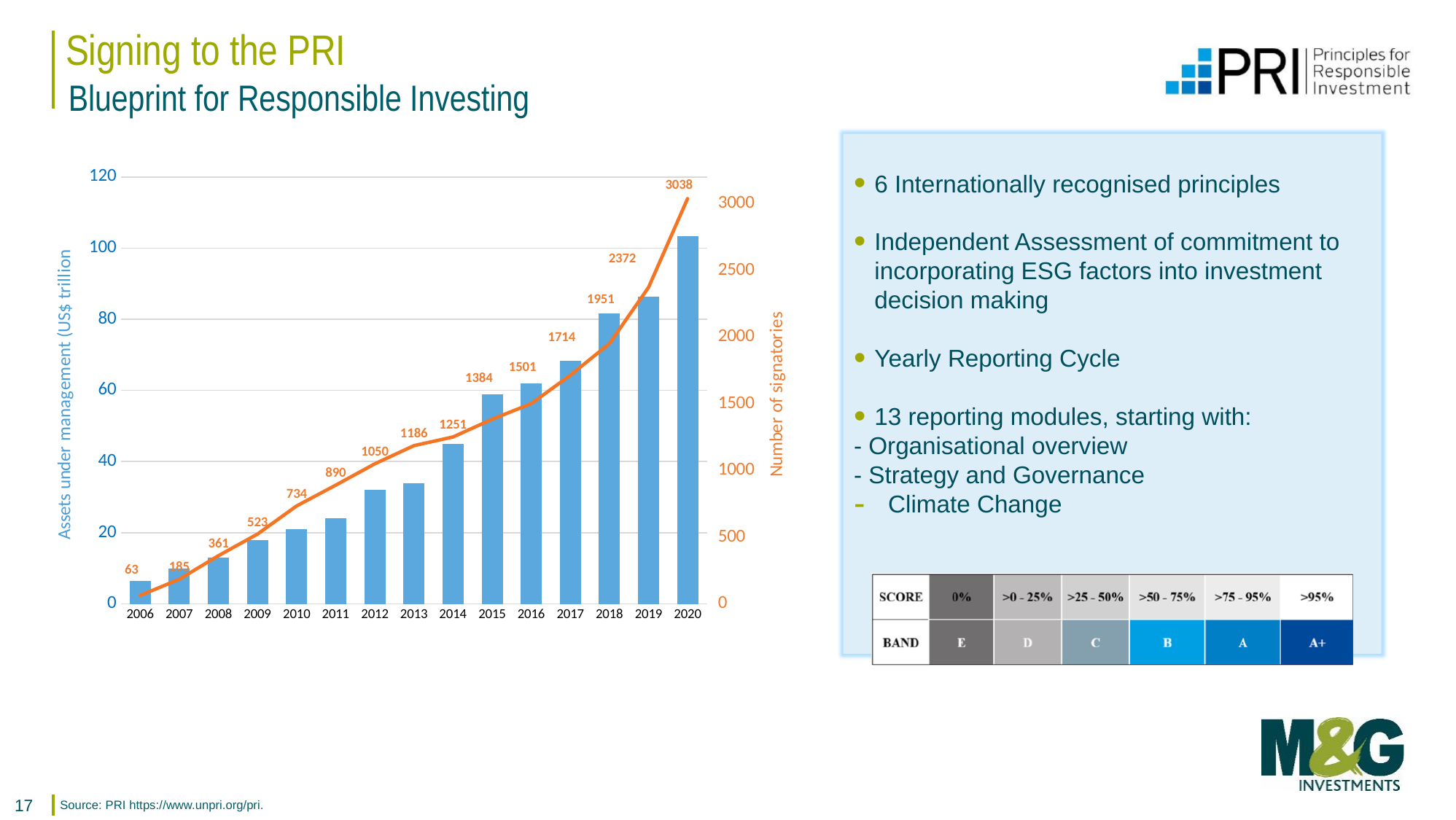
Which year has the highest number of signatories? 2020 How many years are shown on the x axis? 15 Which year has more signatories, 2012 or 2016? 2016 What is the difference in the number of signatories between 2019 and 2018? 421 Is the assets under management value for 2006 greater or less than 20? less Does the number of signatories rise or fall from 2006 to 2020? Rise What kind of chart is this? Combined bar and line chart What is the number of signatories shown for 2020? 3038 What is the number of signatories shown for 2006? 63 What is the number of signatories shown for 2014? 1251 Which year has the lowest number of signatories? 2006 Is the assets under management value for 2020 greater or less than 100? greater